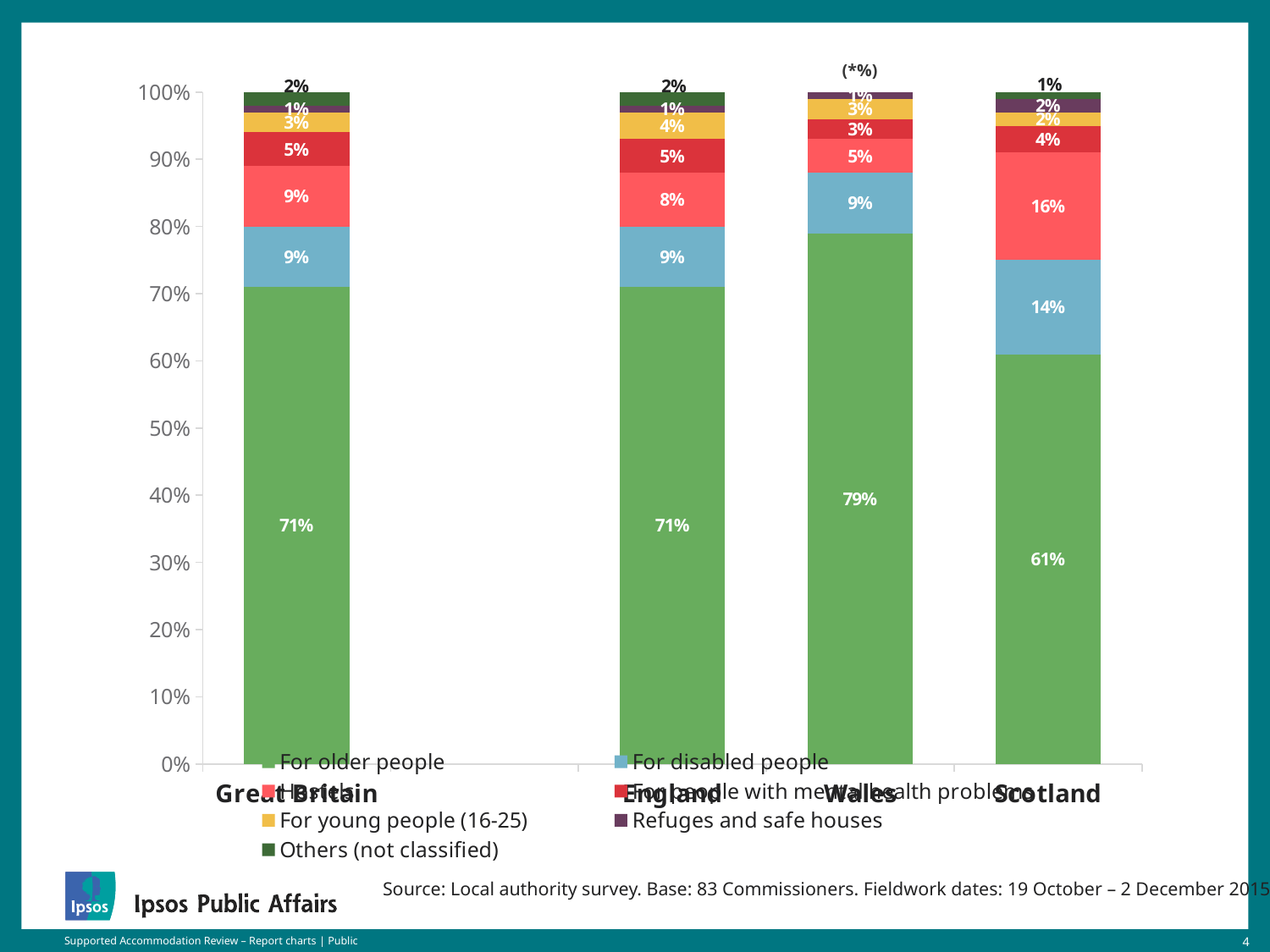
What is the value for 'For disabled people' in Scotland? 14% Which country has the highest share for 'For older people'? Wales Which country has the lowest share for 'For older people'? Scotland What is the value for 'Hostels' in Scotland? 16% What is the value for 'For older people' in Wales? 79% What share of supported accommodation in Scotland is for older people? 61% What is the difference between the 'For older people' share in Wales and in Scotland? 18% What is the value for 'For people with mental health problems' in England? 5% What type of chart is shown on the slide? Stacked bar chart How many countries/regions are shown on the x axis? 4 How many series does the legend list? 7 Is the 'Hostels' share larger in Scotland or in England? Scotland